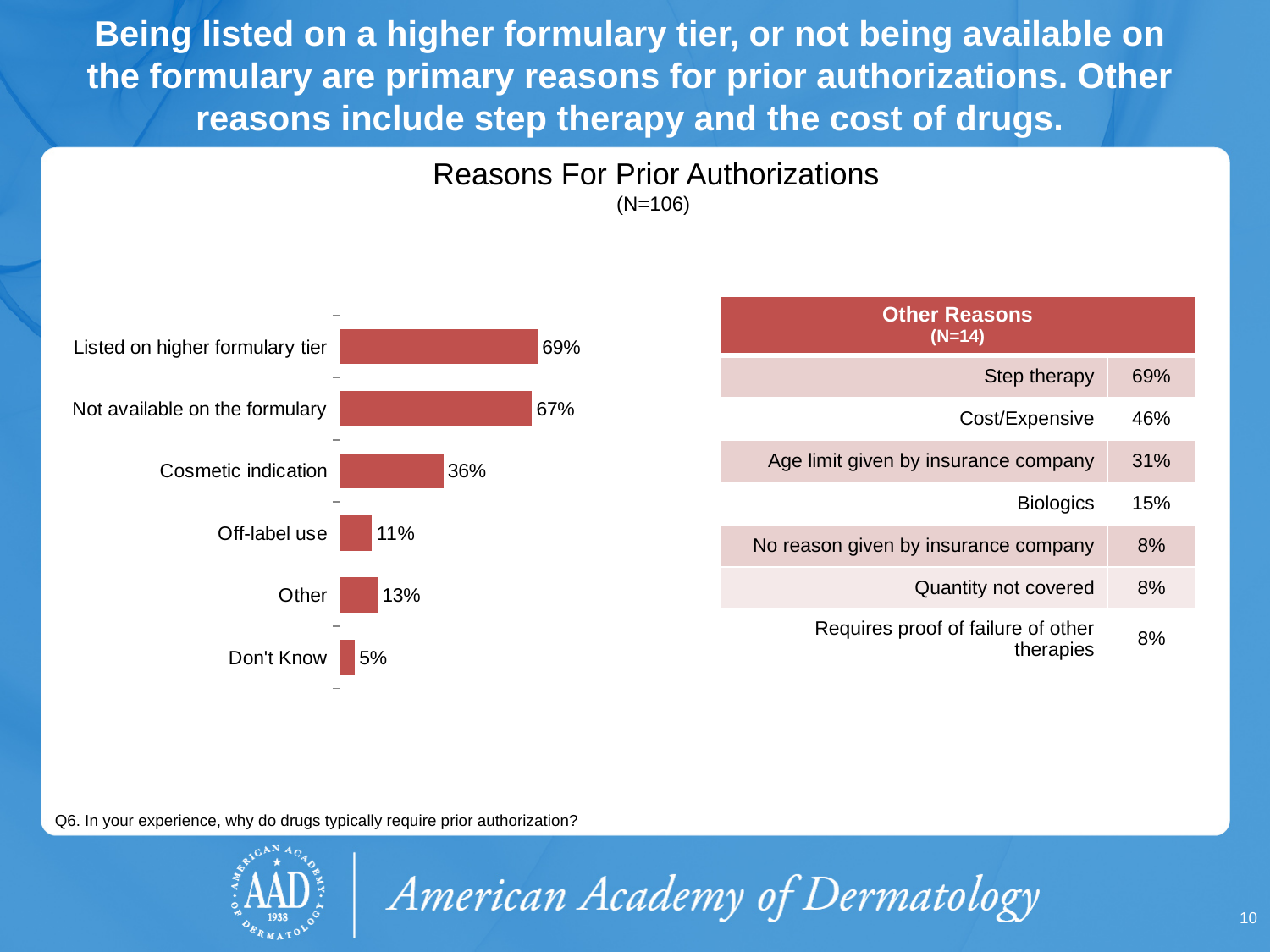
What is the title of the chart on the slide? Reasons For Prior Authorizations Which category has the lowest value in the Reasons For Prior Authorizations chart? Don't Know What is the sample size (N) shown under the chart title Reasons For Prior Authorizations? N=106 What is the value for 'Don't Know' in the Reasons For Prior Authorizations chart? 5% What type of chart is used to show the Reasons For Prior Authorizations? Bar chart What is the value for 'Cosmetic indication' in the Reasons For Prior Authorizations chart? 36% Which is larger, 'Other' or 'Off-label use'? Other What percentage of respondents cited 'Listed on higher formulary tier' as a reason for prior authorizations? 69% How many categories are shown in the Reasons For Prior Authorizations bar chart? 6 What is the difference between 'Cosmetic indication' and 'Off-label use'? 25% Which reason has the highest value in the Reasons For Prior Authorizations chart? Listed on higher formulary tier What is the difference between 'Listed on higher formulary tier' and 'Not available on the formulary'? 2%